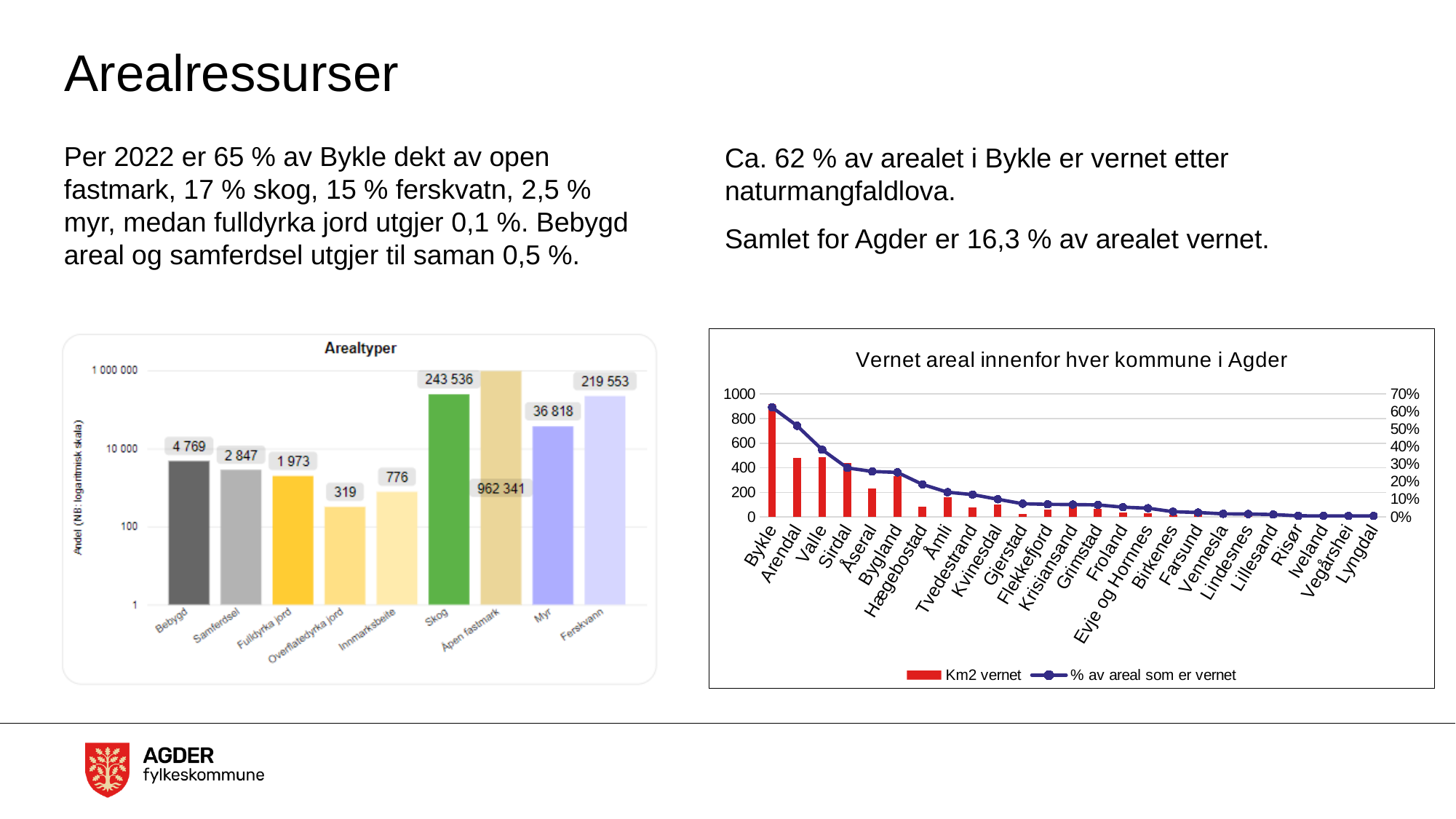
How many municipalities are shown on the x axis of the chart 'Vernet areal innenfor hver kommune i Agder'? 25 In the Arealtyper chart, which category has the lowest value? Overflatedyrka jord In the Arealtyper chart, what is the value for Myr? 36 818 How many categories are shown in the Arealtyper chart? 9 In the chart 'Vernet areal innenfor hver kommune i Agder', which municipality has the highest Km2 vernet? Bykle In the Arealtyper chart, which is larger, Skog or Ferskvann? Skog In the Arealtyper chart, what is the difference between Bebygd and Samferdsel? 1 922 In the Arealtyper chart, what is the value for Skog? 243 536 In the chart 'Vernet areal innenfor hver kommune i Agder', is the Km2 vernet value for Arendal greater or less than 400? greater In the chart 'Vernet areal innenfor hver kommune i Agder', how many series does the legend list? 2 In the Arealtyper chart, which category has the highest value? Åpen fastmark In the chart 'Vernet areal innenfor hver kommune i Agder', does the '% av areal som er vernet' line rise or fall from left to right? fall